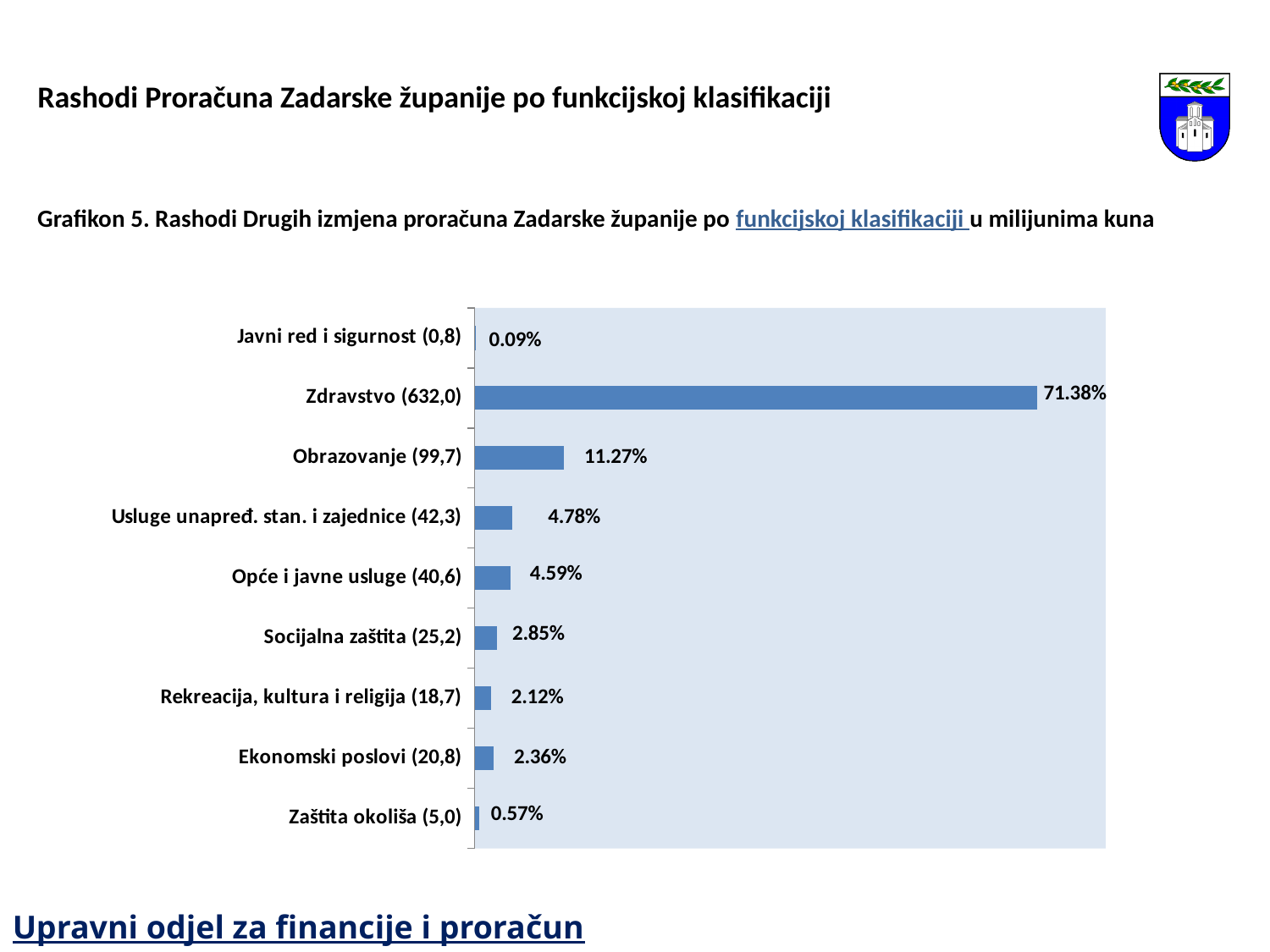
Which category has the highest percentage? Zdravstvo Which has a larger percentage, Ekonomski poslovi or Rekreacija, kultura i religija? Ekonomski poslovi What is the difference in percentage points between Zdravstvo and Obrazovanje? 60.11% How many categories are shown in the chart? 9 What percentage is shown for Zaštita okoliša? 0.57% What amount in millions of kuna is shown in the label for Obrazovanje? 99,7 What is the difference in percentage points between Usluge unapređ. stan. i zajednice and Opće i javne usluge? 0.19% What type of chart is shown on the slide? Bar chart What percentage is shown for Socijalna zaštita? 2.85% What percentage is shown for Obrazovanje? 11.27% What percentage is shown for Zdravstvo? 71.38% Which category has the lowest percentage? Javni red i sigurnost